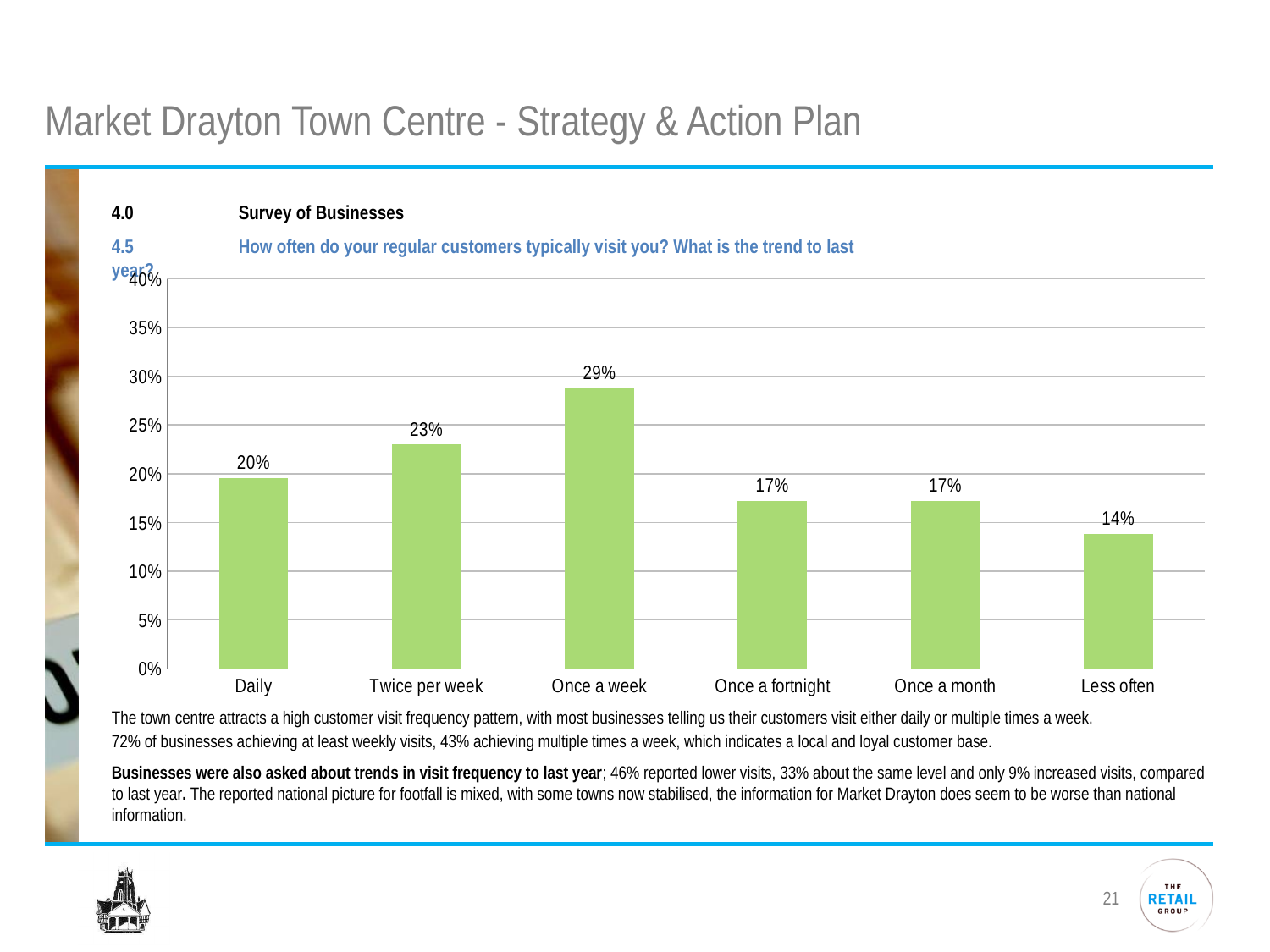
Which category has the lowest value? Less often Which is larger, the value for Twice per week or the value for Once a fortnight? Twice per week Is the value for Once a month greater or less than 20%? less What is the value for Less often? 14% How many categories are shown on the x axis? 6 Which category has the highest value? Once a week What is the value for Twice per week? 23% What is the difference between the values for Once a week and Daily? 9% What kind of chart is shown on the slide? bar chart What is the value for Once a week? 29% What is the highest value shown on the y axis? 40% What is the value for Daily? 20%